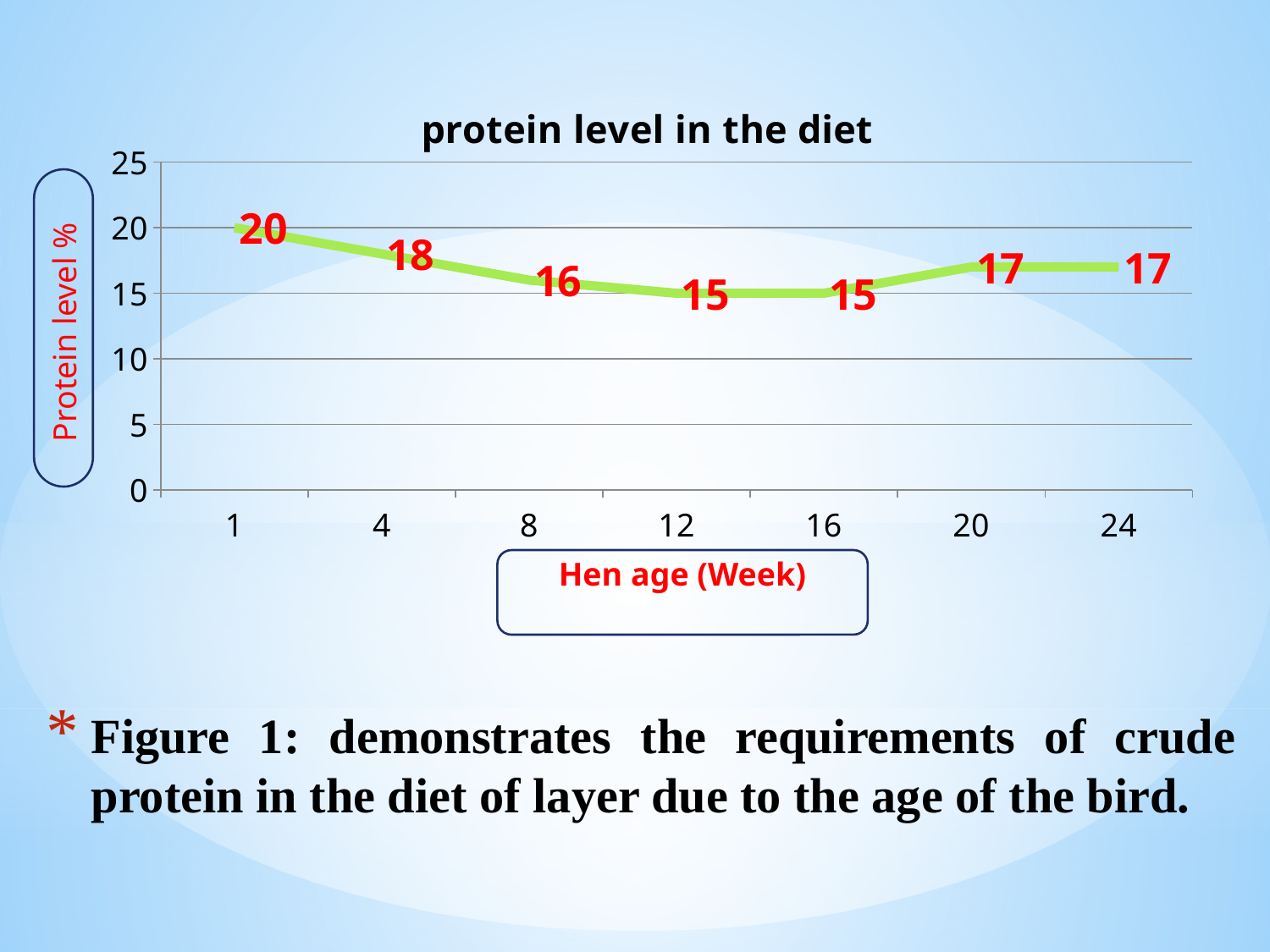
How many hen age points are plotted on the chart? 7 What is the protein level in the diet at hen age 24 weeks? 17 What kind of chart is shown on the slide? line chart What is the difference between the protein level at week 4 and at week 20? 1 Does the protein level rise or fall from week 1 to week 12? fall What is the protein level in the diet at hen age 8 weeks? 16 What is the title of the chart? protein level in the diet At which hen age is the protein level in the diet highest? 1 Which is larger, the protein level at week 4 or at week 16? week 4 What is the lowest protein level shown on the chart? 15 What is the protein level in the diet at hen age 1 week? 20 What is the difference between the protein level at week 1 and the protein level at week 12? 5